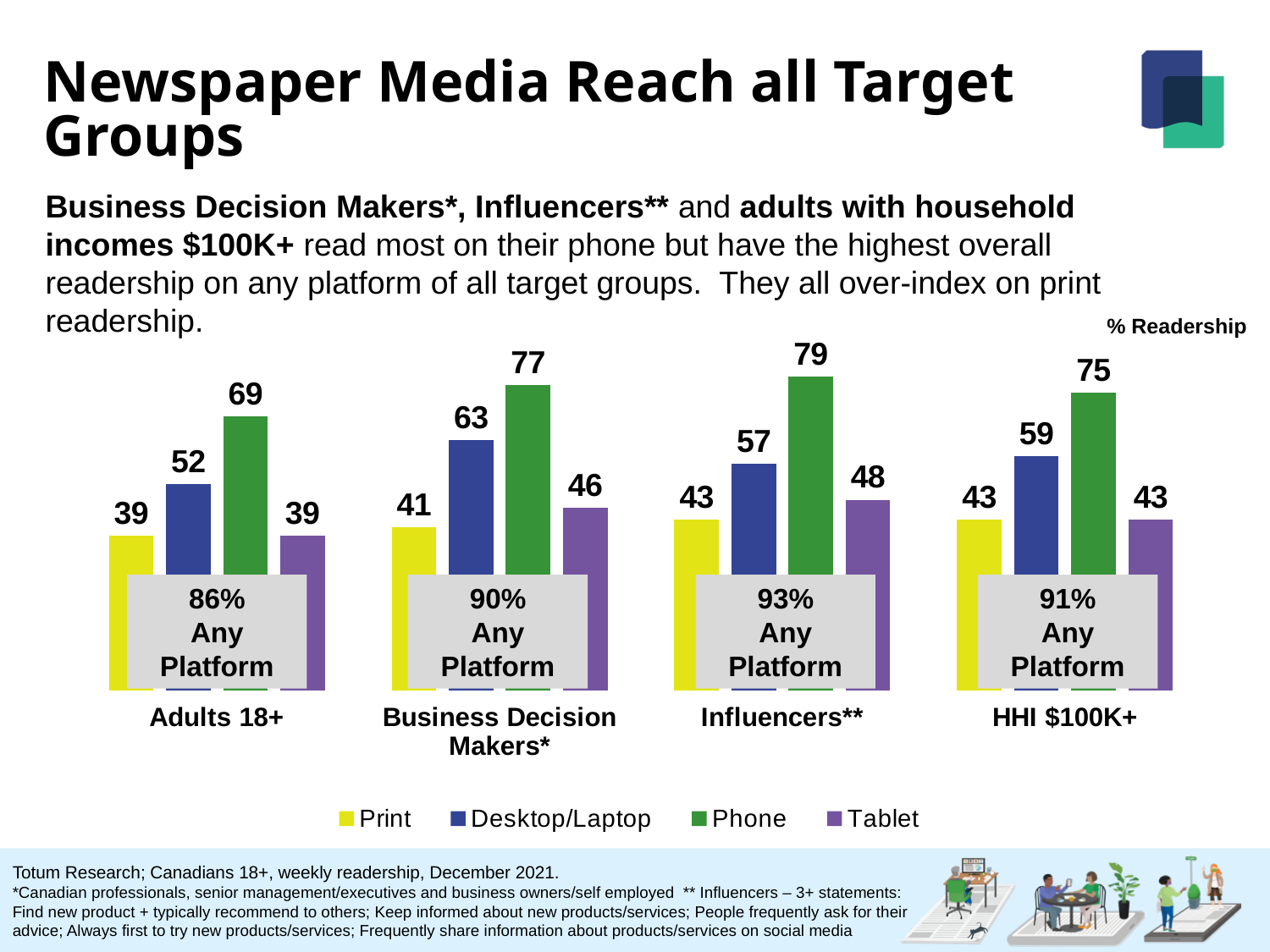
What is the difference between the Phone and Print readership values for Business Decision Makers*? 36 Which target group has the highest Phone readership? Influencers** Which is larger for HHI $100K+: the Desktop/Laptop value or the Tablet value? Desktop/Laptop Which target group has the lowest Desktop/Laptop readership? Adults 18+ How many target groups are shown on the x axis of the chart? 4 What is the 'Any Platform' readership shown for Influencers**? 93% What is the Desktop/Laptop readership value for HHI $100K+? 59 What is the Tablet readership value for Adults 18+? 39 What kind of chart is shown on the slide? Bar chart How many series does the chart legend list? 4 What is the Phone readership value for Influencers**? 79 What is the Print readership value for Business Decision Makers*? 41